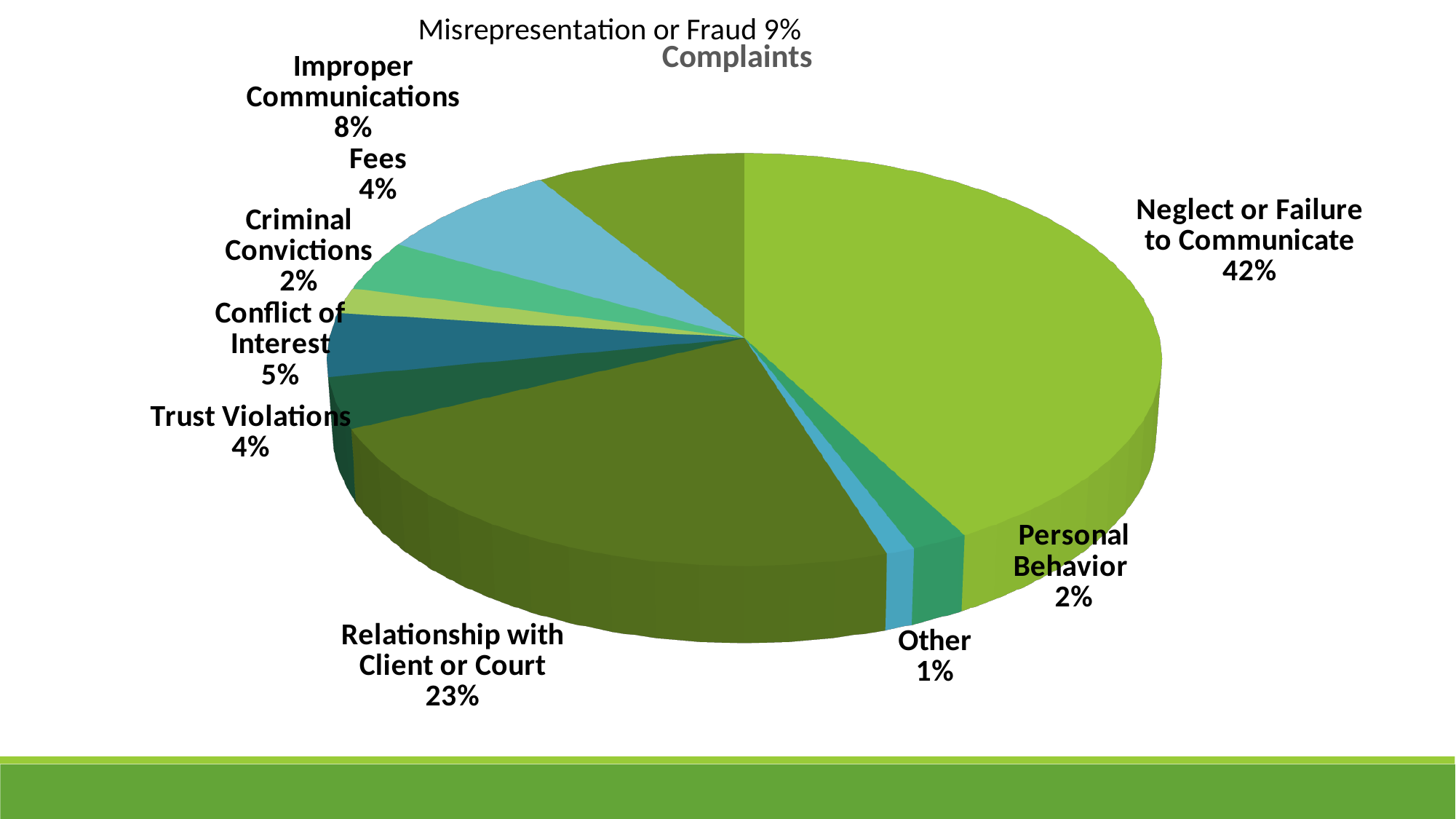
How many categories are shown in the pie chart? 10 Which is larger, Improper Communications or Fees? Improper Communications What is the difference in percentage points between Neglect or Failure to Communicate and Relationship with Client or Court? 19 What is the title of the chart? Complaints Which category has the smallest share of complaints? Other What share of complaints is Neglect or Failure to Communicate? 42% What share of complaints is Misrepresentation or Fraud? 9% What share of complaints is Relationship with Client or Court? 23% What share of complaints is Conflict of Interest? 5% Which category has the largest share of complaints? Neglect or Failure to Communicate What kind of chart is shown on the slide? Pie chart What is the combined share of Trust Violations and Fees? 8%